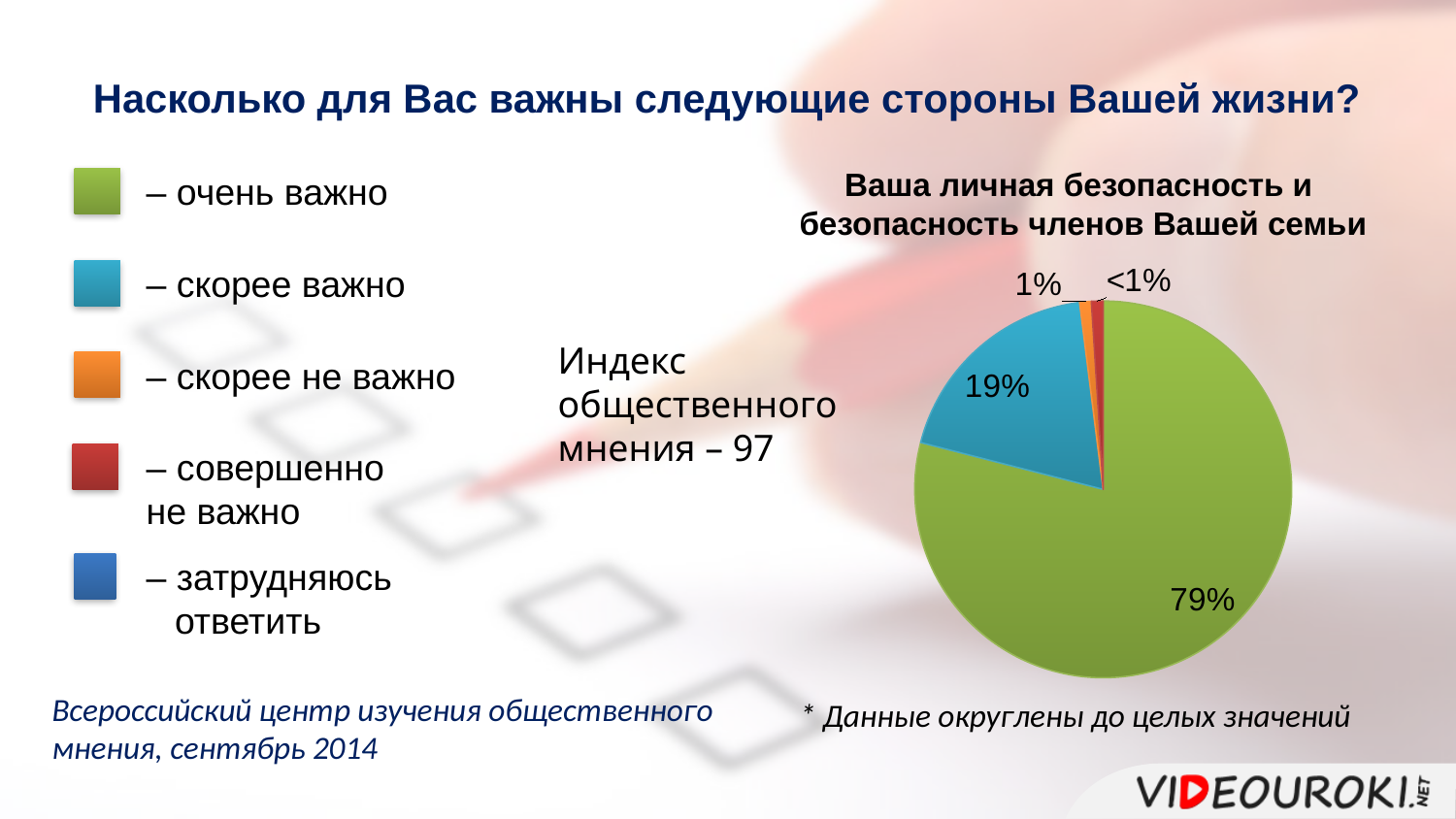
What share is shown for "совершенно не важно"? <1% Which is larger: the share for "очень важно" or for "скорее важно"? очень важно What is the title of the pie chart? Ваша личная безопасность и безопасность членов Вашей семьи Is the share for "скорее важно" greater or less than 50%? less Which answer option has the largest slice of the pie? очень важно What kind of chart is shown on the slide? pie chart What share of respondents answered "скорее важно"? 19% What share of respondents answered "скорее не важно"? 1% What share of respondents answered "очень важно" about personal and family safety? 79% How many answer options does the legend on the left list? 5 Which colour represents the answer "очень важно" in the chart? green By how many percentage points does the "очень важно" share exceed the "скорее важно" share? 60 percentage points